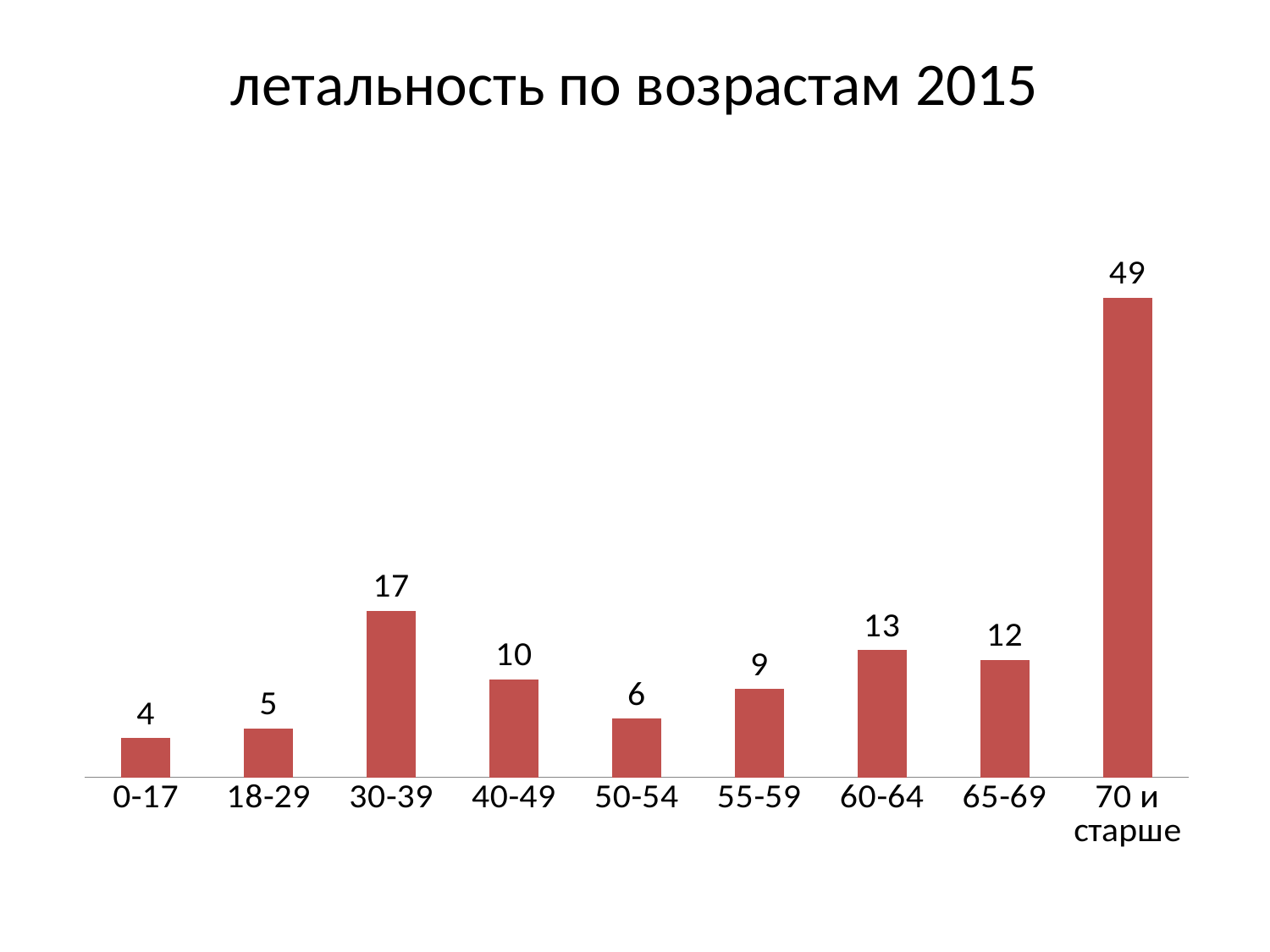
What is the title of the chart? летальность по возрастам 2015 What is the value for the 70 и старше age group? 49 Which age group has the lowest value? 0-17 Which age group has the highest value? 70 и старше Which is larger, the value for 40-49 or the value for 55-59? 40-49 What is the value for the 30-39 age group? 17 What is the difference between the values for 70 и старше and 30-39? 32 How many age groups are shown on the chart? 9 What kind of chart is shown on the slide? Bar chart What is the difference between the values for 60-64 and 65-69? 1 What is the value for the 50-54 age group? 6 What is the value for the 60-64 age group? 13